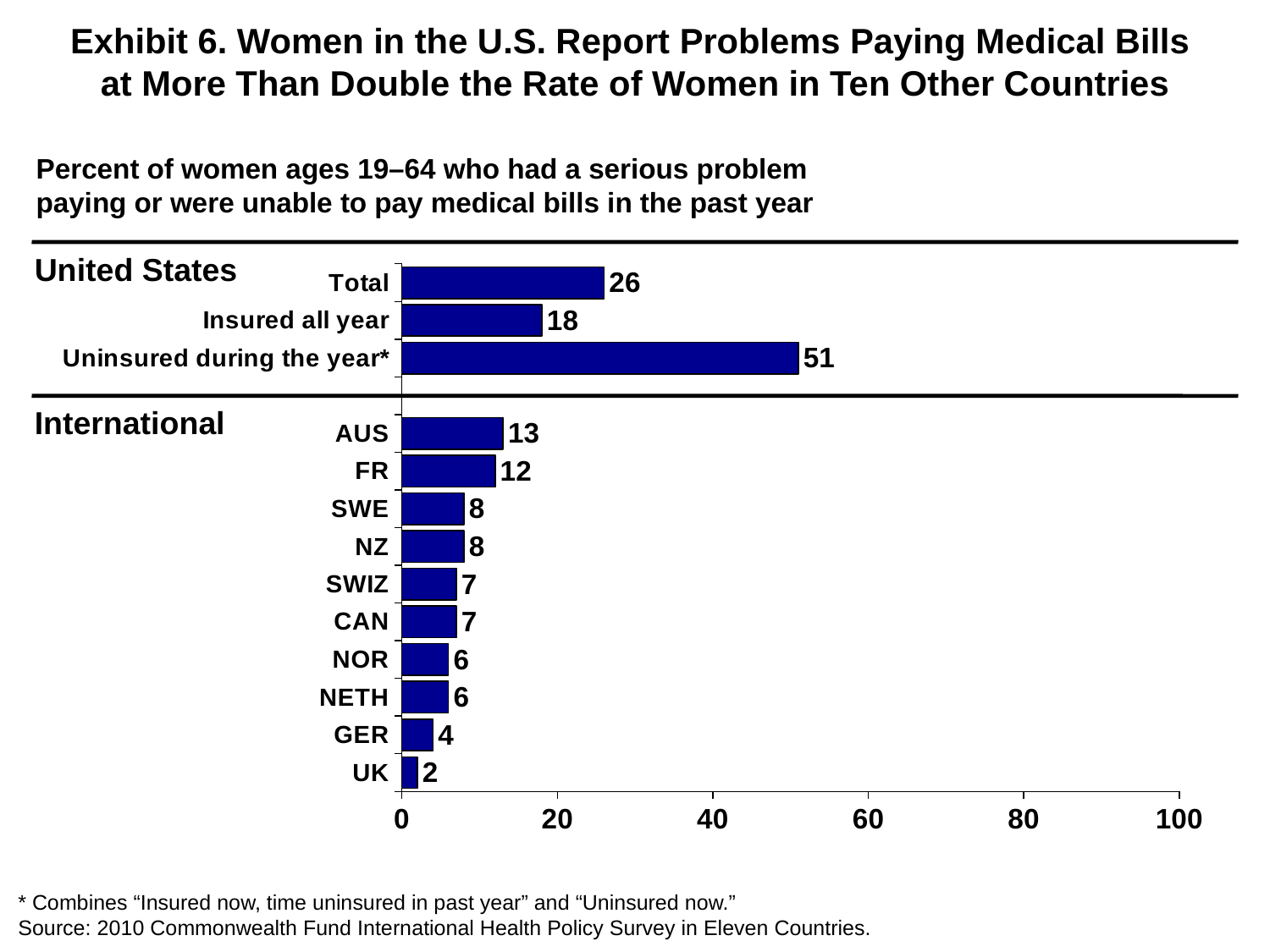
What is the difference between the values for Total and AUS? 13 Which is larger, the value for FR or the value for SWE? FR What is the value for AUS? 13 What kind of chart is shown on the slide? bar chart What is the value for GER? 4 What is the value for Uninsured during the year*? 51 What is the value for Insured all year? 18 What is the difference between the values for Uninsured during the year* and Insured all year? 33 Is the value for Uninsured during the year* greater or less than 40? greater Which category has the lowest value? UK Which category has the highest value? Uninsured during the year* How many bars are plotted in the chart? 13